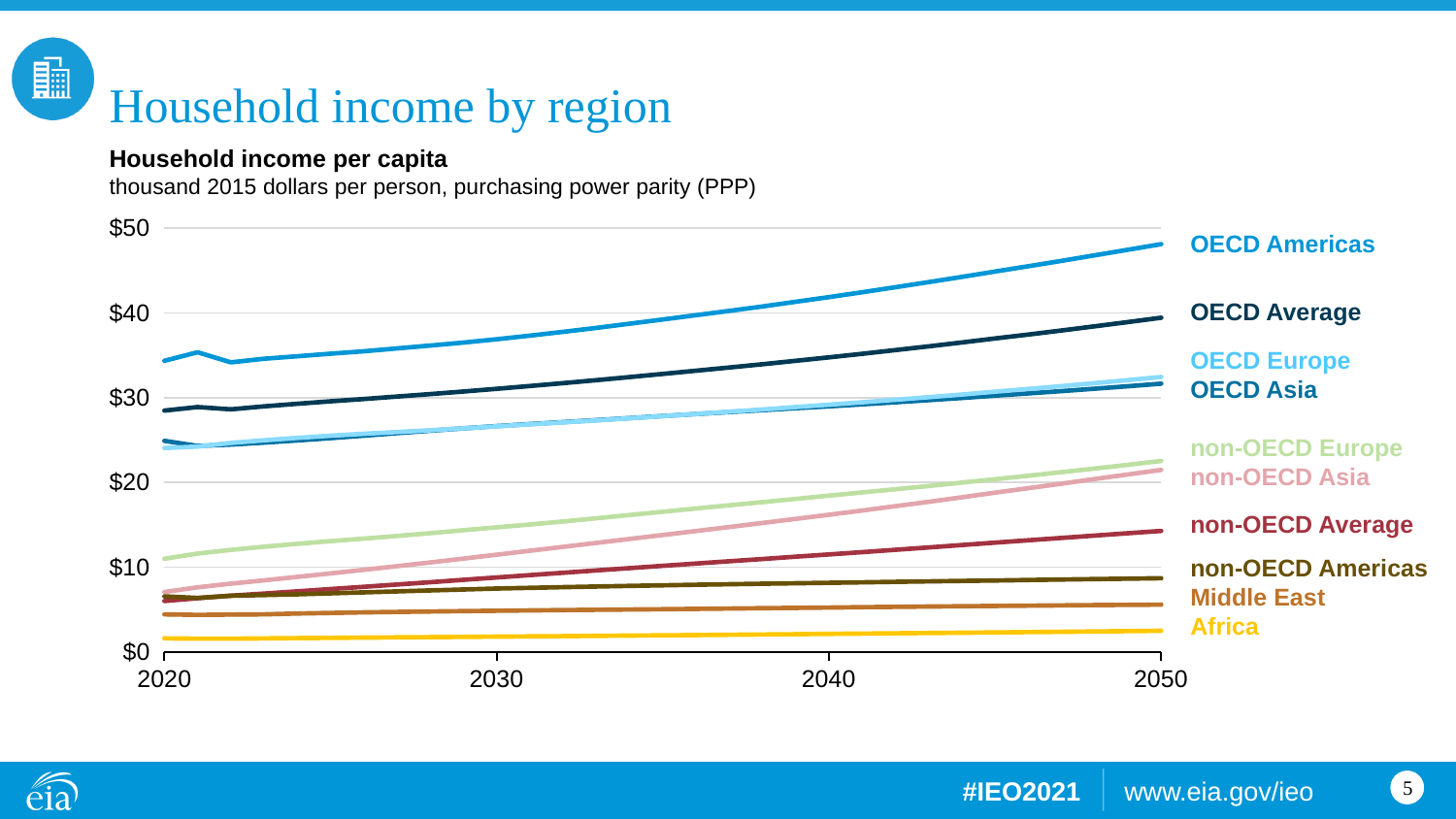
Which region has the lowest household income per capita across the chart? Africa Which region has the highest household income per capita in 2050? OECD Americas Is the value for non-OECD Europe in 2050 greater or less than $20? greater In 2050, which is larger: OECD Average or non-OECD Average? OECD Average Is the value for OECD Average in 2020 greater or less than $30? less Is the value for OECD Americas in 2050 greater or less than $40? greater Does household income per capita for OECD Americas rise or fall from 2020 to 2050? rise How many regional series are plotted on the chart? 10 What unit is household income per capita measured in on this chart? thousand 2015 dollars per person, purchasing power parity (PPP) What is the title of the chart? Household income per capita What kind of chart is shown on the slide? line chart